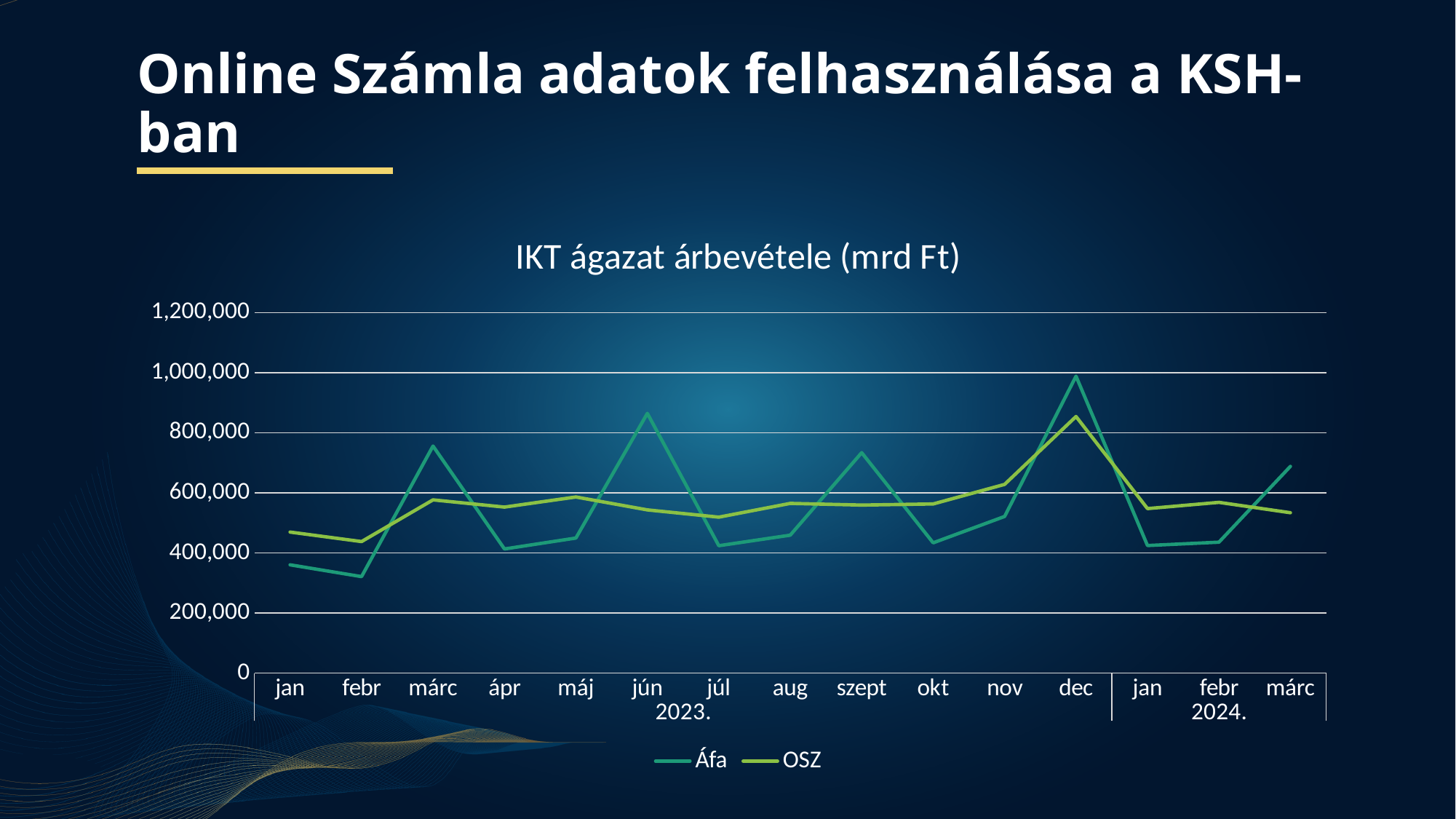
How many series does the legend list? 2 In which month does the Áfa series reach its lowest value? febr 2023 In which month does the Áfa series reach its highest value? dec 2023 Which series has the larger value in jún 2023, Áfa or OSZ? Áfa What is the title of the chart? IKT ágazat árbevétele (mrd Ft) In which month does the OSZ series reach its highest value? dec 2023 Which two series are listed in the legend? Áfa and OSZ Is the Áfa value for dec 2023 greater or less than 800,000? greater Is the Áfa value for febr 2023 greater or less than 400,000? less What kind of chart is shown on the slide? line chart Does the Áfa series rise or fall from jan 2024 to márc 2024? rise How many months are plotted along the x axis? 15